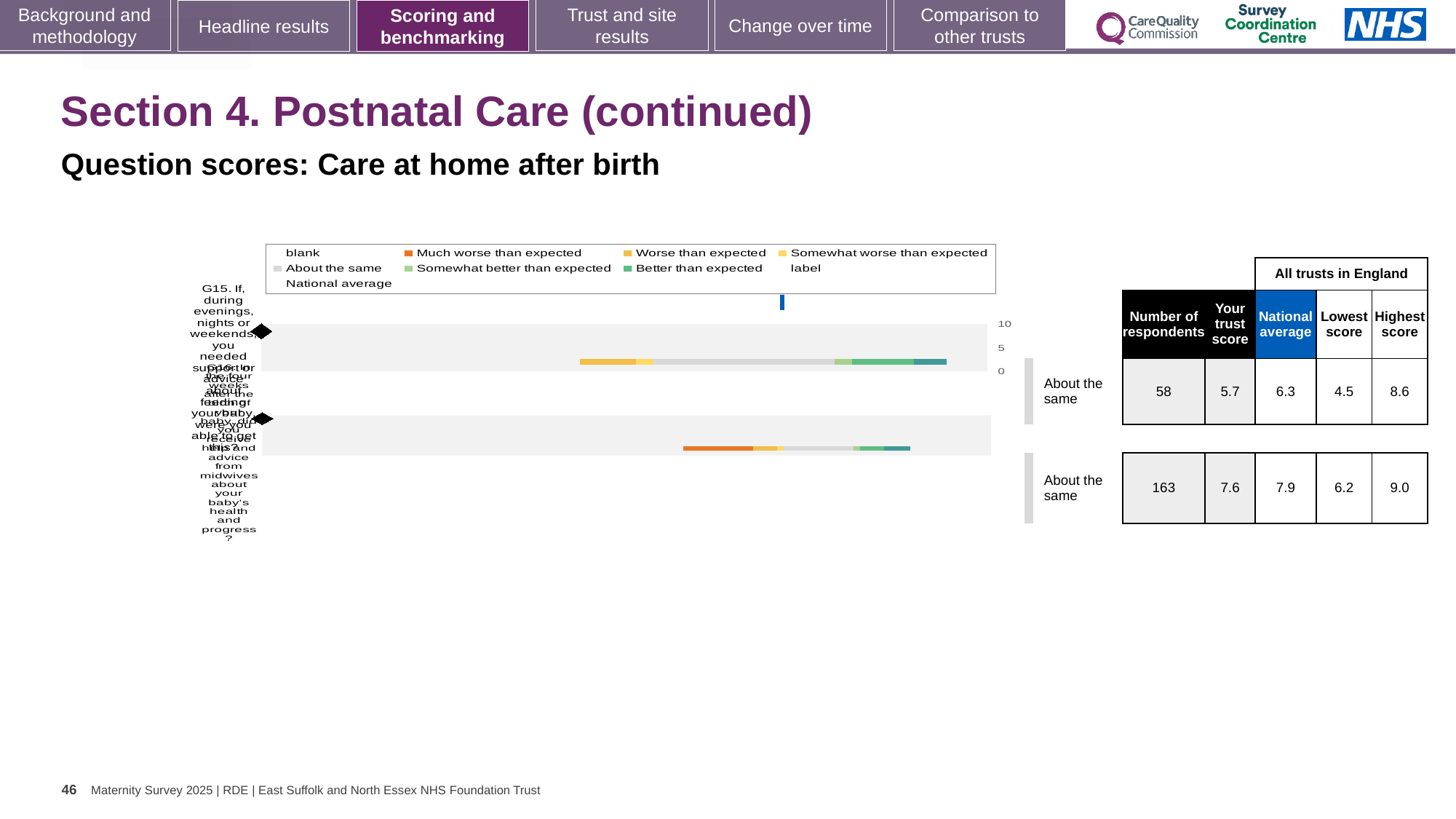
What is the national average for the bottom row of the table? 7.9 What is the difference between the trust score and the national average for the top row of the table? 0.6 What is the highest score among all trusts in England for the bottom row of the table? 9.0 What is the lowest score among all trusts in England for the top row of the table? 4.5 What is the number of respondents for the top row of the table? 58 How many entries does the chart legend list? 9 What kind of chart is shown on the slide? bar chart Which row of the table has more respondents, the top row or the bottom row? bottom row What benchmark category is shown next to both bars in the chart? About the same What is the subtitle describing the question scores on this slide? Question scores: Care at home after birth How many bars (question rows) does the chart show? 2 What is the trust score for the top row of the table? 5.7